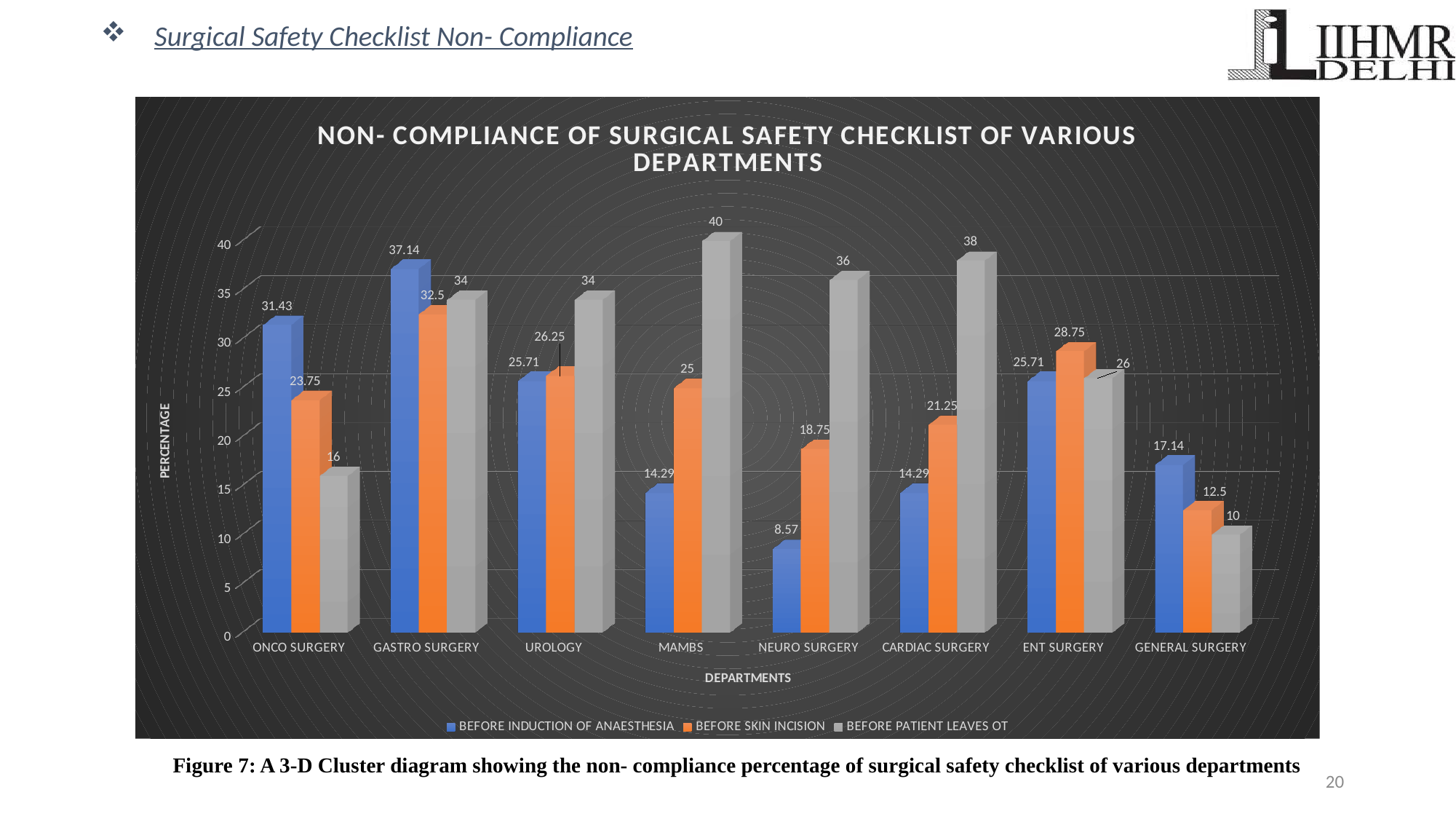
For Cardiac Surgery, which is larger: the Before Patient Leaves OT value or the Before Skin Incision value? Before Patient Leaves OT What is the Before Skin Incision value for General Surgery? 12.5 What is the Before Patient Leaves OT value for MAMBS? 40 Which department has the highest value in the Before Skin Incision series? Gastro Surgery What is the non-compliance value for Gastro Surgery in the Before Induction of Anaesthesia series? 37.14 For Neuro Surgery, how much higher is the Before Patient Leaves OT value than the Before Induction of Anaesthesia value? 27.43 Which department has the highest value in the Before Patient Leaves OT series? MAMBS How many series does the legend list? 3 How many departments are shown on the x axis? 8 Which department has the lowest value in the Before Induction of Anaesthesia series? Neuro Surgery For Onco Surgery, what is the difference between the Before Induction of Anaesthesia value and the Before Skin Incision value? 7.68 What kind of chart is shown on the slide? Bar chart